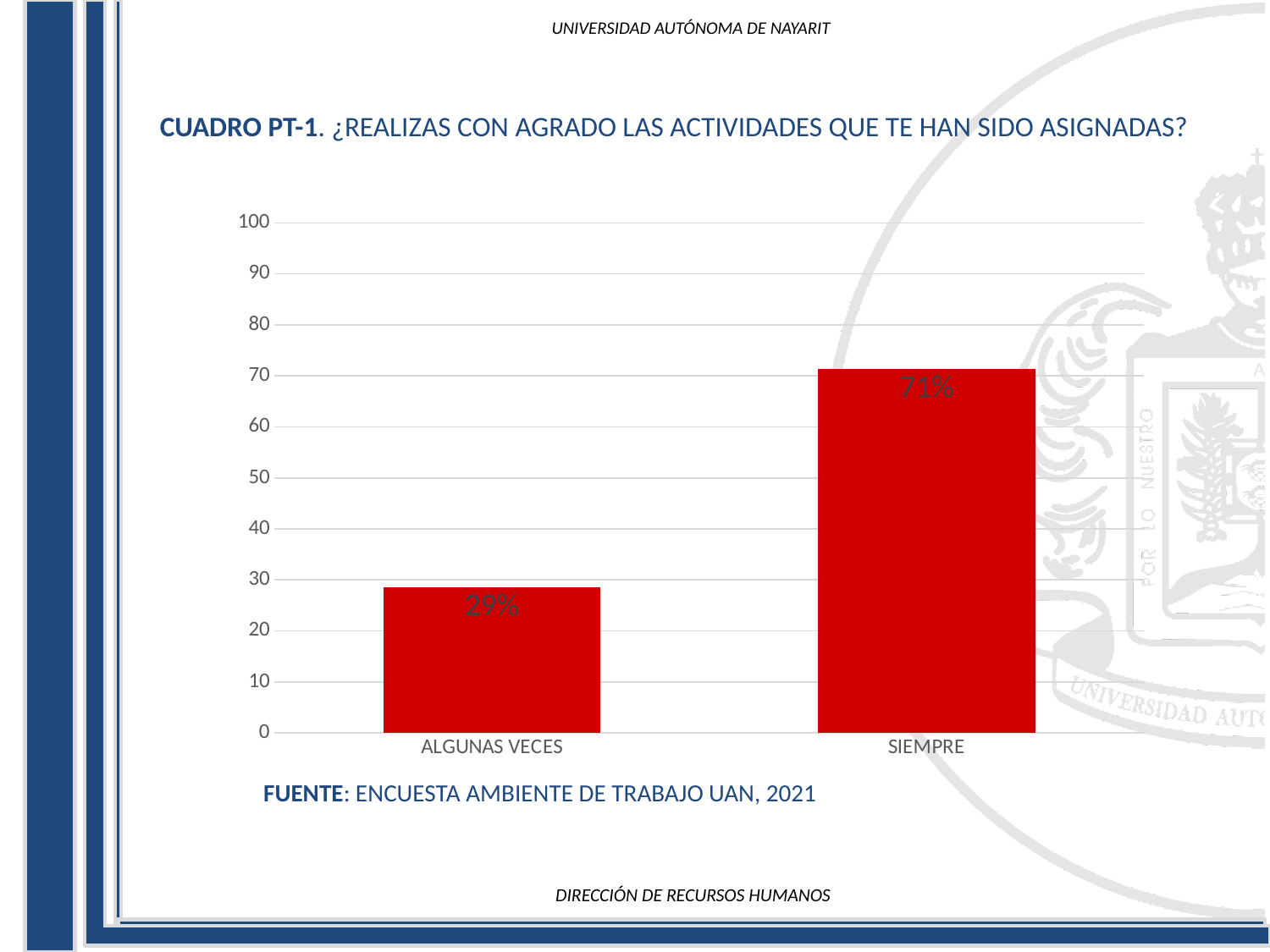
Which category has the lowest value? ALGUNAS VECES What kind of chart is shown on the slide? bar chart What is the value for ALGUNAS VECES? 29% Is the value for SIEMPRE greater or less than 60? greater What is the difference between the values for SIEMPRE and ALGUNAS VECES? 42% Which category has the highest value? SIEMPRE What colour are the bars in the chart? red What is the highest value shown on the y axis? 100 Is the value for ALGUNAS VECES greater or less than 40? less What is the value for SIEMPRE? 71% Which is larger, the value for ALGUNAS VECES or the value for SIEMPRE? SIEMPRE How many categories are shown on the x axis? 2